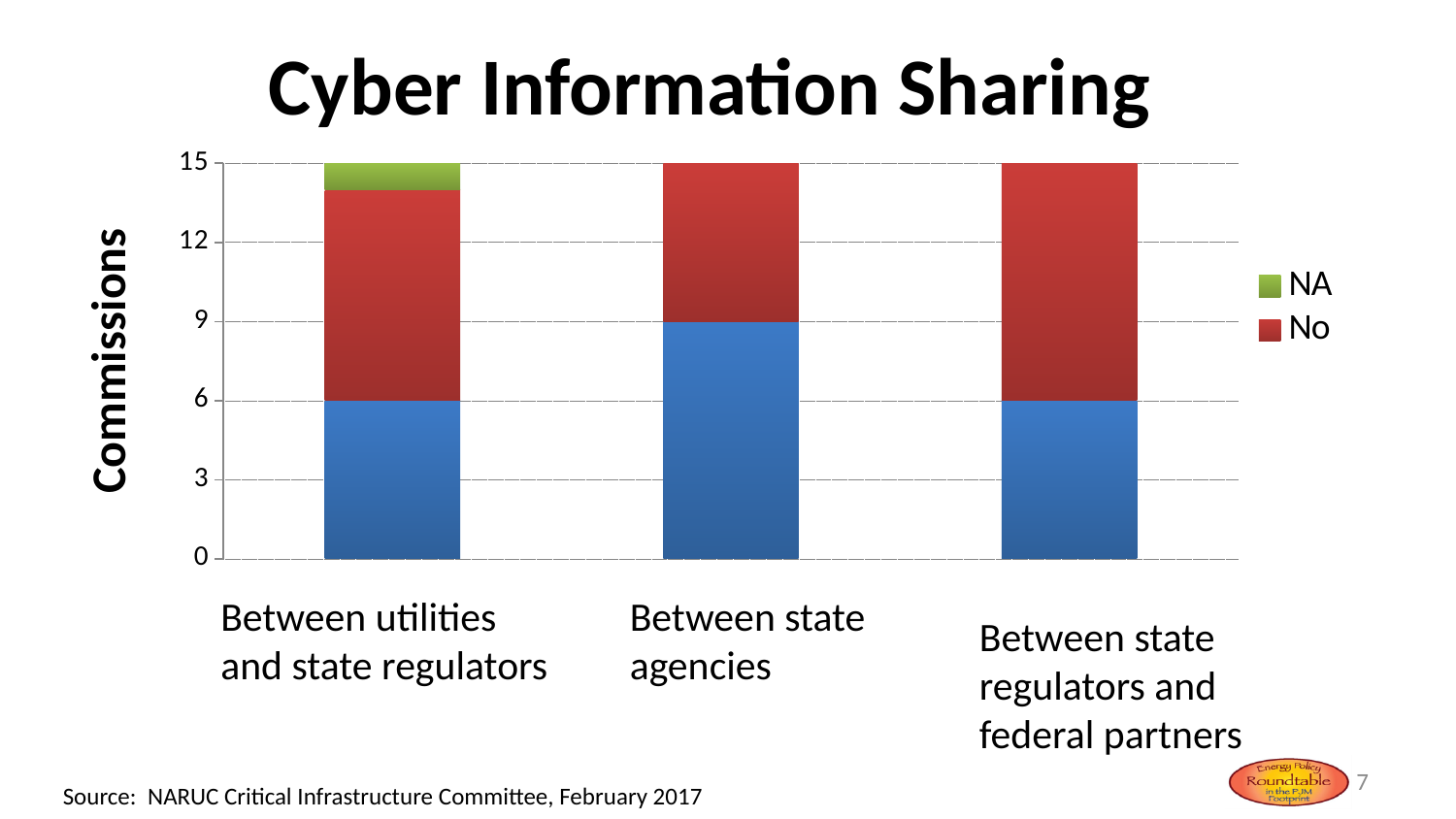
What kind of chart is shown on the slide? bar chart Is the "No" value for "Between state regulators and federal partners" greater or less than 6? greater What is the "No" value for "Between state agencies"? 6 Which category has an "NA" segment in its bar? Between utilities and state regulators What is the label on the y axis of the chart? Commissions What is the total height of the stacked bar for "Between state agencies"? 15 How many series does the chart's legend list? 2 Which category has the smallest "No" value? Between state agencies How many categories are shown on the x axis of the chart? 3 Is the "No" value for "Between state agencies" greater or less than 9? less Which has the larger "No" value: "Between state agencies" or "Between state regulators and federal partners"? Between state regulators and federal partners What is the total height of the stacked bar for "Between utilities and state regulators"? 15